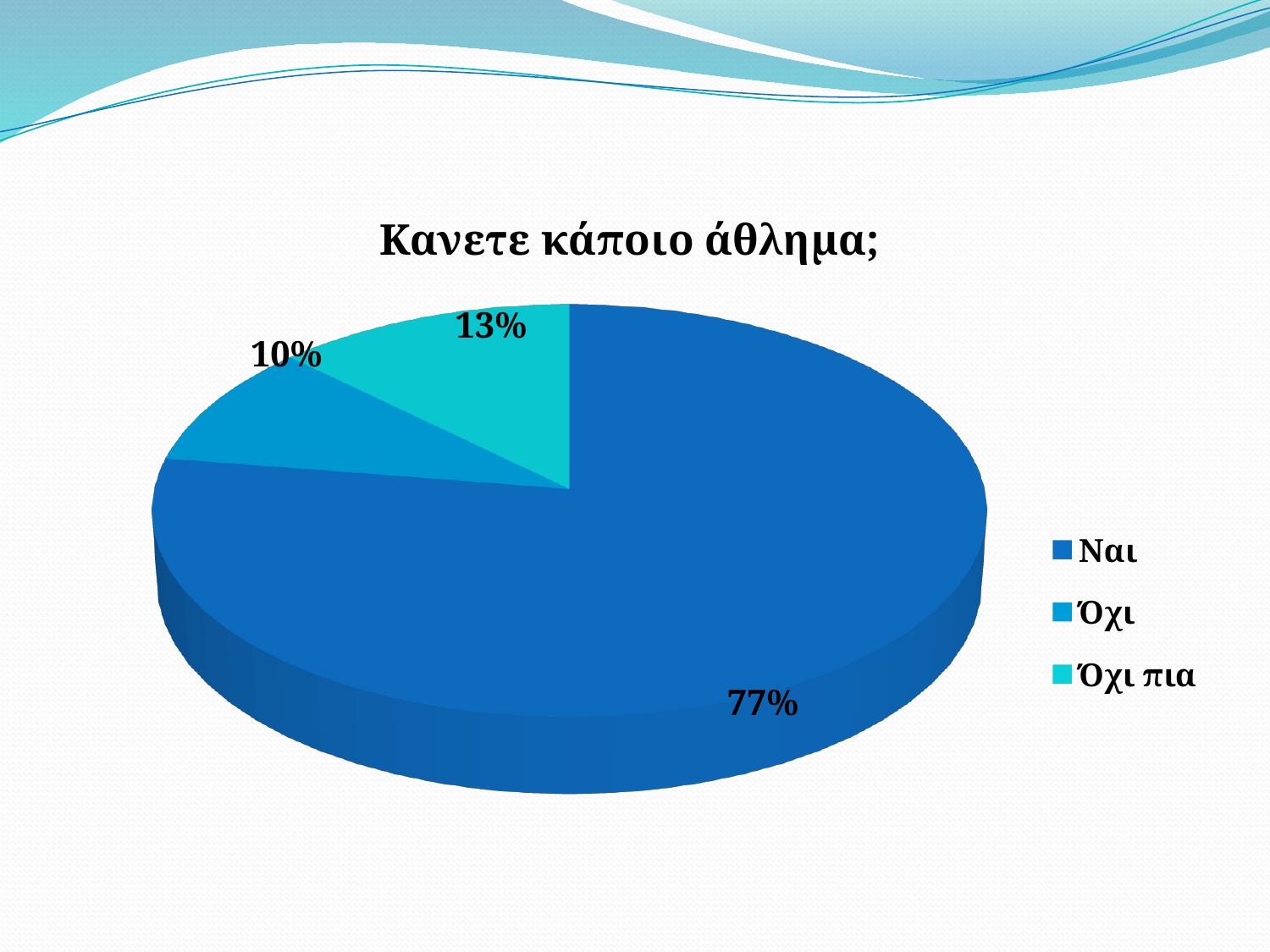
What share of the pie does the "Όχι" slice represent? 10% Which legend entry is shown in the lightest (cyan) colour? Όχι πια What kind of chart is shown on the slide? Pie chart Which category has the largest slice of the pie? Ναι What is the title of the chart? Κανετε κάποιο άθλημα; What is the difference in percentage points between the "Όχι πια" slice and the "Όχι" slice? 3 Which slice is larger, "Όχι" or "Όχι πια"? Όχι πια What share of the pie does the "Ναι" slice represent? 77% What share of the pie does the "Όχι πια" slice represent? 13% How many categories does the pie chart show? 3 What is the difference in percentage points between the "Ναι" slice and the "Όχι πια" slice? 64 Which category has the smallest slice of the pie? Όχι